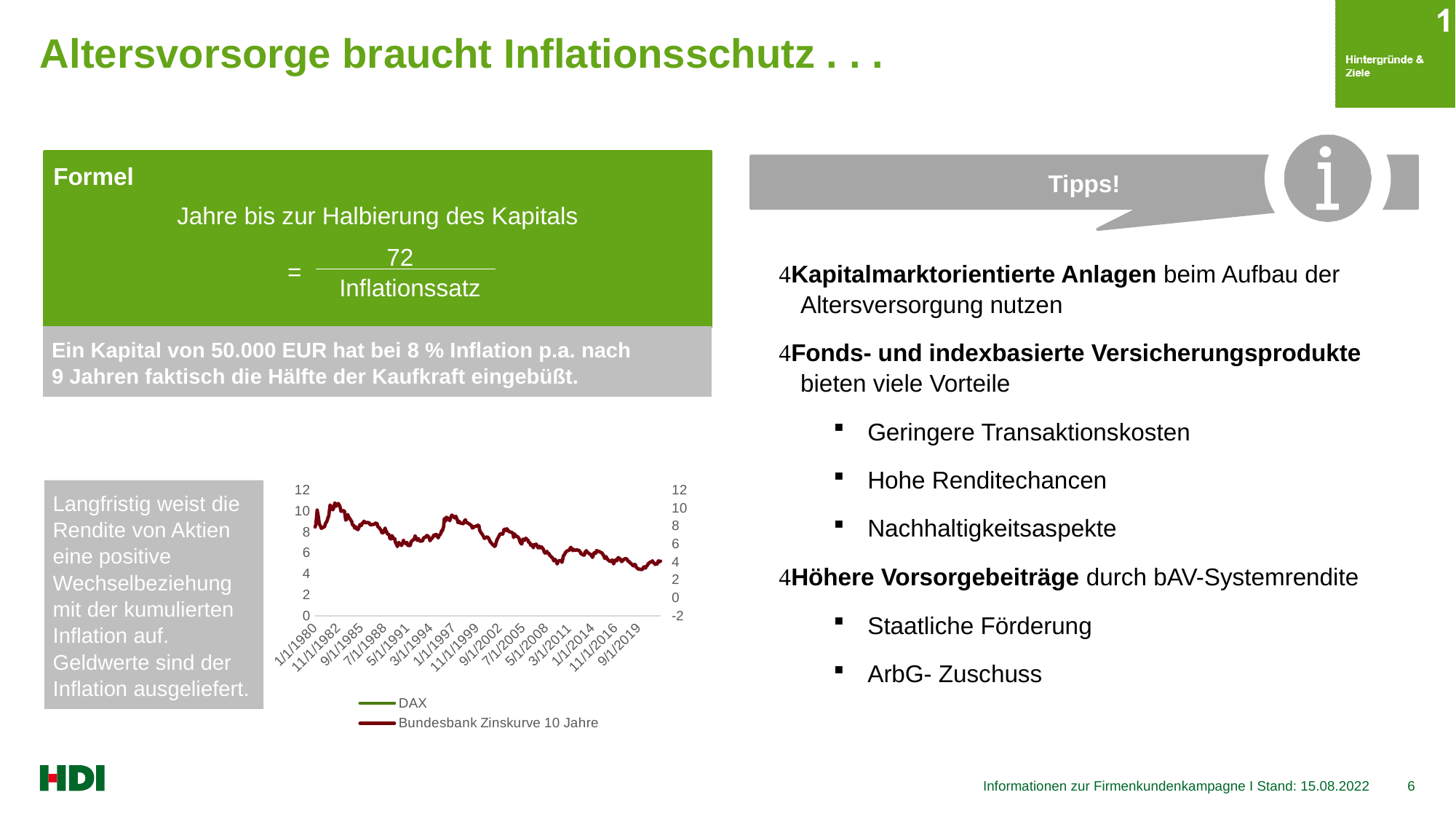
How many date labels are shown on the x axis of the chart? 15 What is the lowest value shown on the right-hand y axis of the chart? -2 Is the Bundesbank Zinskurve 10 Jahre value higher around 11/1/1982 or around 9/1/2019? 11/1/1982 What kind of chart is shown at the bottom of the slide? line chart How many series does the legend of the chart list? 2 Around which x-axis label does the Bundesbank Zinskurve 10 Jahre line reach its highest value? 11/1/1982 What is the first date label on the x axis of the chart? 1/1/1980 Does the Bundesbank Zinskurve 10 Jahre line overall rise or fall from 1/1/1980 to 9/1/2019? fall What are the two series named in the chart legend? DAX and Bundesbank Zinskurve 10 Jahre What colour is the Bundesbank Zinskurve 10 Jahre line in the chart? dark red Is the peak value of the Bundesbank Zinskurve 10 Jahre line around 11/1/1982 greater or less than 8? greater Is the value of the Bundesbank Zinskurve 10 Jahre line at 9/1/2019 greater or less than 6? less